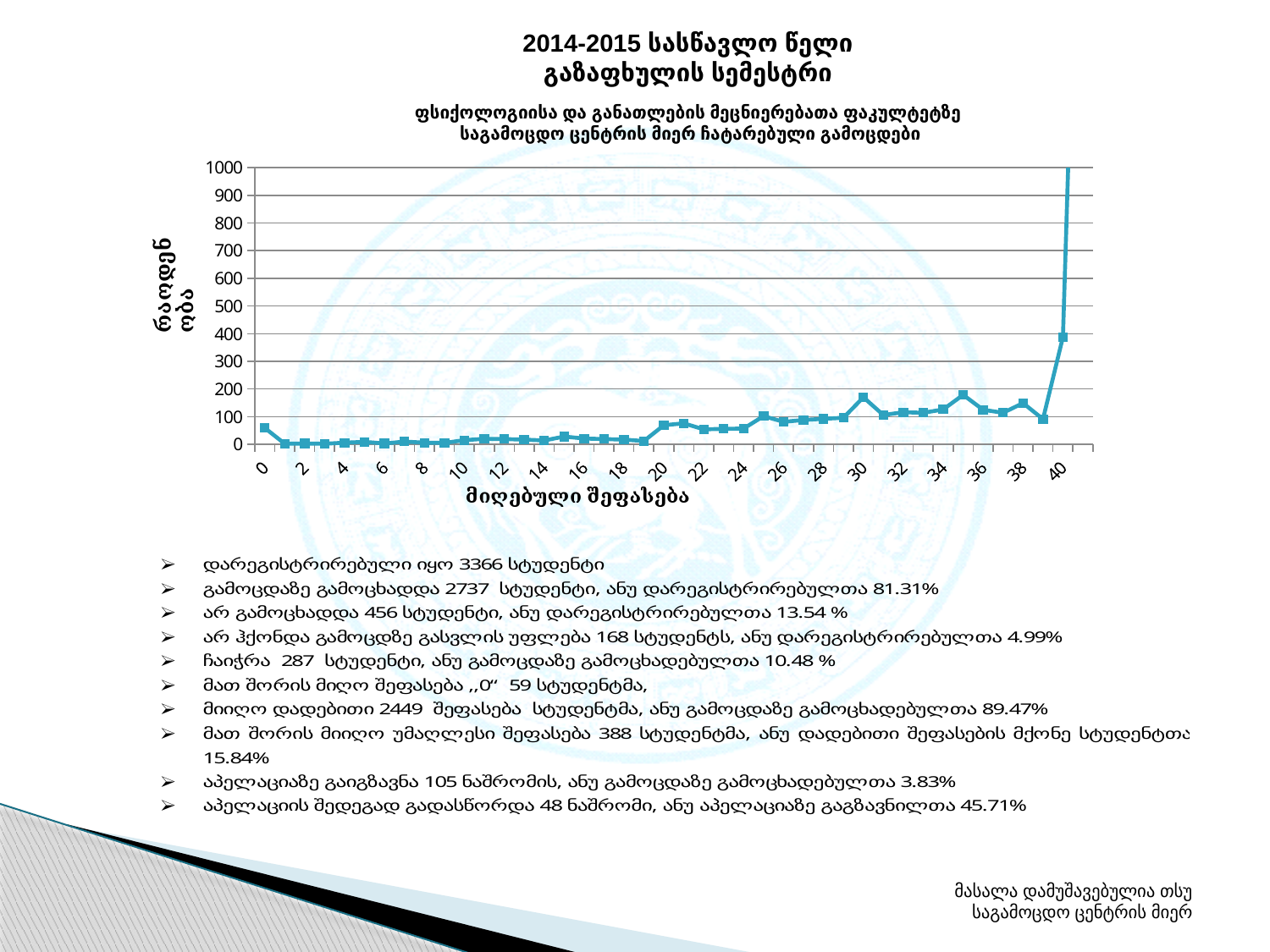
What is the highest value shown on the y axis? 1000 Is the value for score 38 greater or less than 100? greater Which is larger, the value for score 30 or the value for score 10? score 30 What kind of chart is shown on the slide? line chart Is the value for score 10 greater or less than 100? less Is the value for score 20 greater or less than 100? less Do the values generally rise or fall as the score increases along the x axis? rise What is the title of the y axis of the chart? რაოდენობა What is the title of the x axis of the chart? მიღებული შეფასება Which is larger, the value for score 35 or the value for score 25? score 35